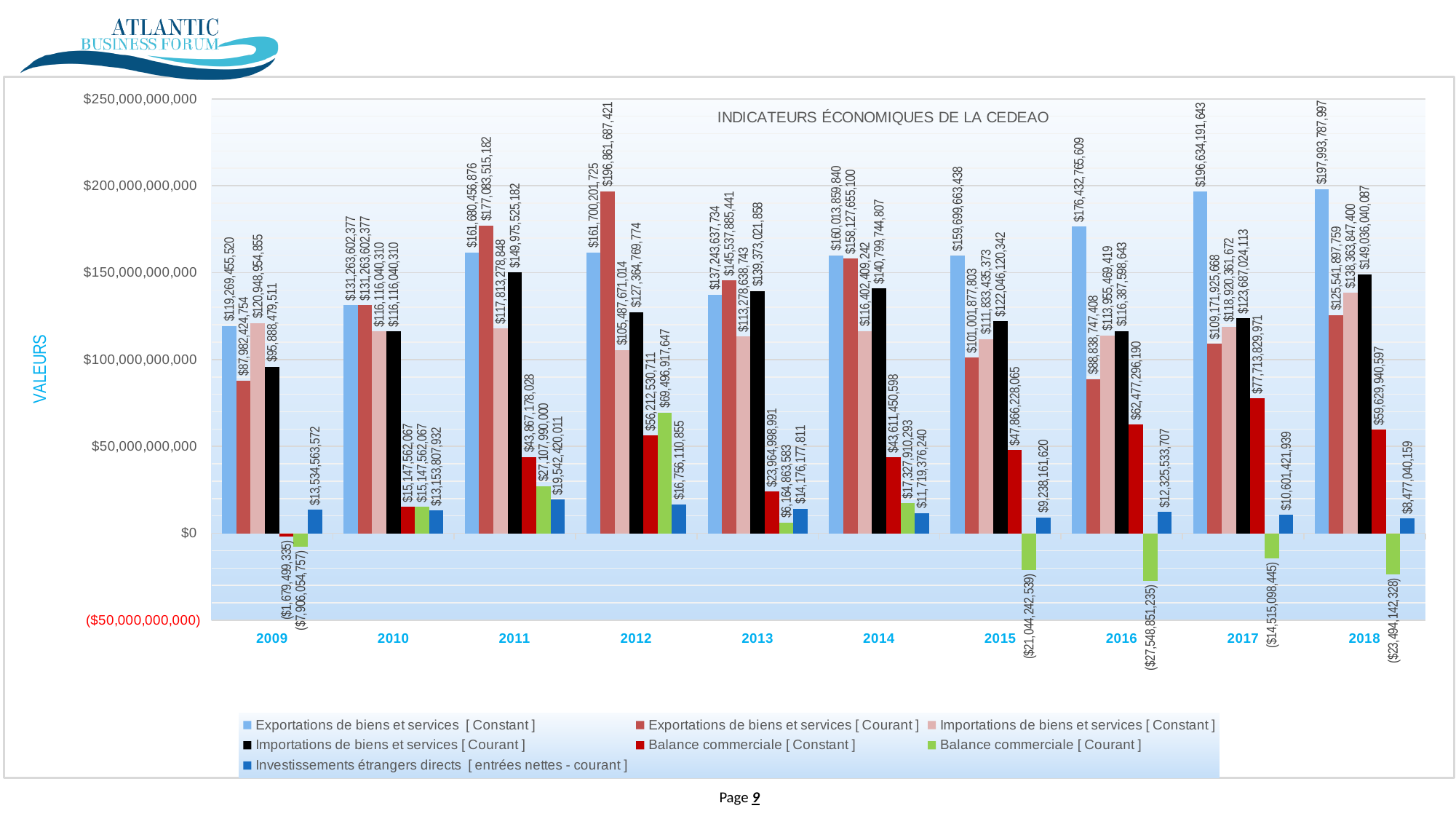
How many years are shown on the x axis? 10 How many series does the legend list? 7 Is the value of Exportations de biens et services [Constant] for 2016 greater or less than $150,000,000,000? greater What is the value of Balance commerciale [Courant] for 2016? ($27,548,851,235) What is the difference between Exportations de biens et services [Courant] and Importations de biens et services [Courant] in 2012? $69,496,917,647 Does Exportations de biens et services [Constant] rise or fall from 2015 to 2018? rise What is the value of Exportations de biens et services [Constant] for 2018? $197,993,787,997 In which year is Balance commerciale [Courant] the lowest? 2016 Which is larger in 2015: Exportations de biens et services [Constant] or Exportations de biens et services [Courant]? Exportations de biens et services [Constant] What kind of chart is shown on the slide? bar chart What is the value of Investissements étrangers directs [entrées nettes - courant] for 2011? $19,542,420,011 In which year is Exportations de biens et services [Courant] the highest? 2012